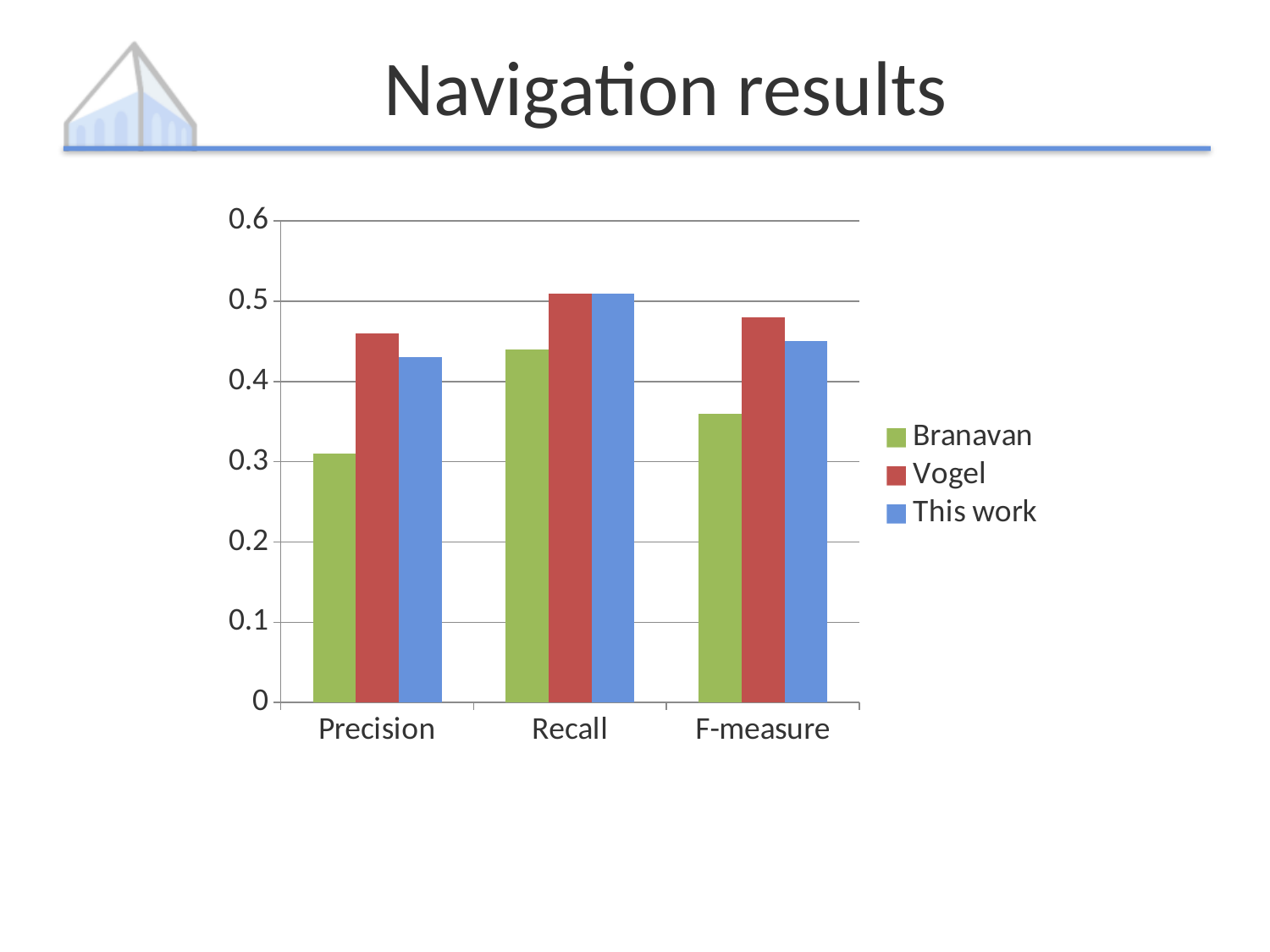
Is the Branavan value for F-measure greater or less than 0.4? less What kind of chart is shown on the slide? bar chart What is the title of the slide containing the chart? Navigation results Is the Branavan value for Recall greater or less than 0.4? greater Which series has the highest value for F-measure? Vogel Is the Branavan value for Precision greater or less than 0.4? less Which series has the lowest value for Precision? Branavan For Precision, which is larger: the Vogel value or the This work value? Vogel How many series does the legend list? 3 How many categories are shown on the x axis? 3